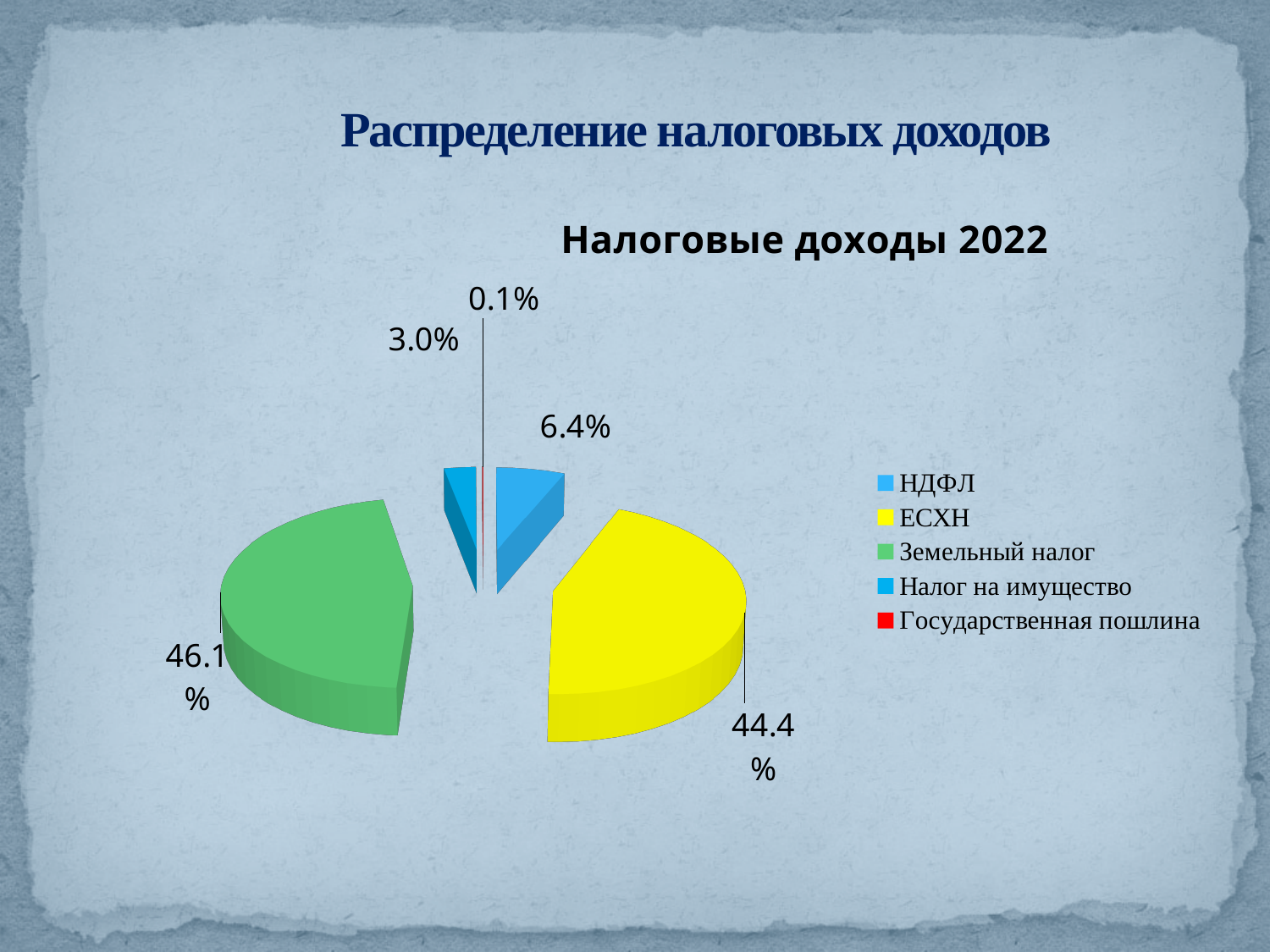
Which category has the smallest share of the pie? Государственная пошлина What share of the pie does Государственная пошлина have? 0.1% How many categories does the legend of the chart list? 5 What share of the pie does Налог на имущество have? 3.0% What is the title of the chart? Налоговые доходы 2022 Which is larger, the share of НДФЛ or the share of Налог на имущество? НДФЛ Which category has the largest share of the pie? Земельный налог What is the difference in percentage points between the shares of Земельный налог and ЕСХН? 1.7 What type of chart is shown on the slide? pie chart What share of the pie does Земельный налог have? 46.1%